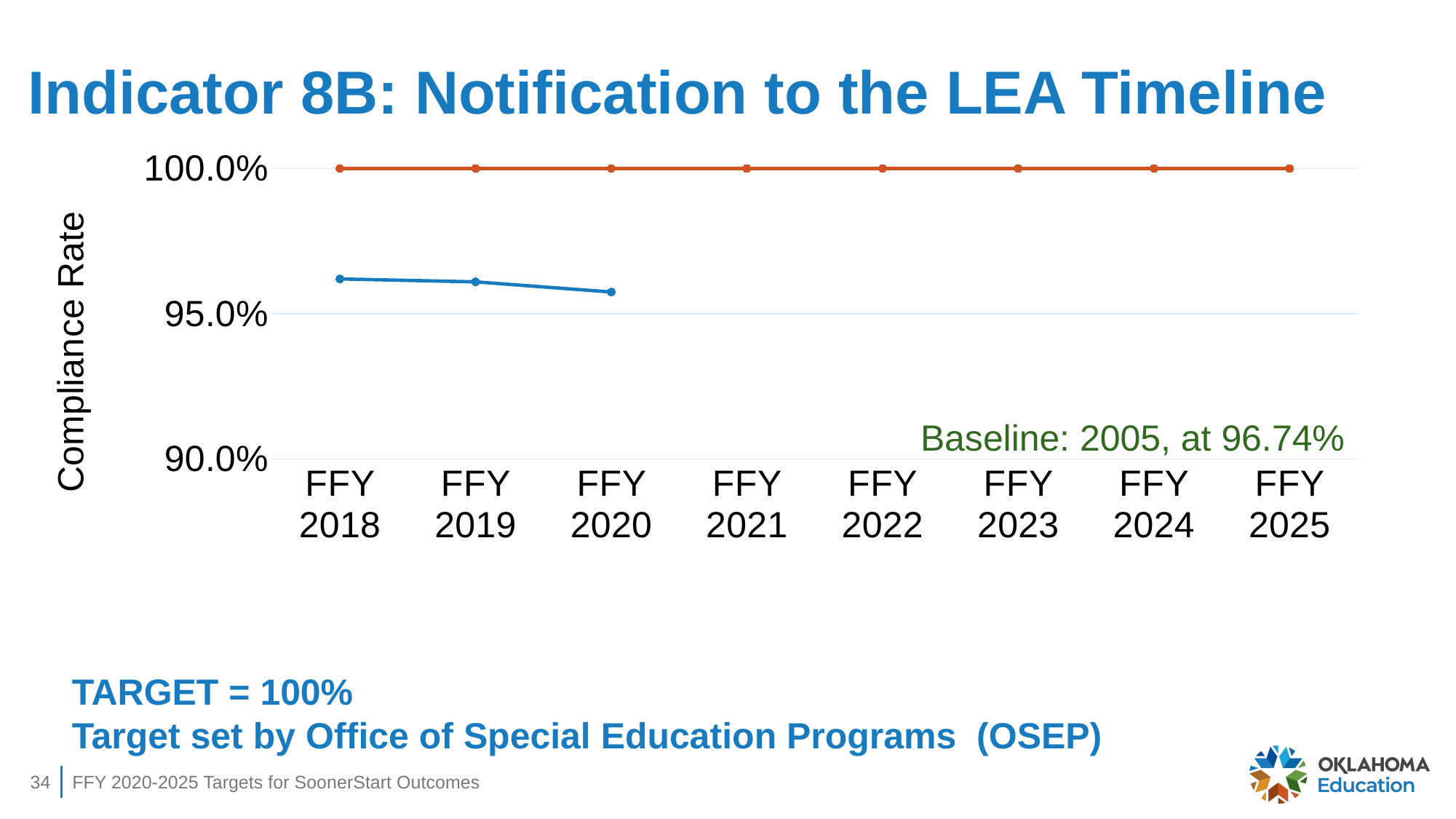
Does the blue line rise or fall from FFY 2018 to FFY 2020? fall What baseline is noted on the chart? Baseline: 2005, at 96.74% Which FFY has the lowest value on the blue line? FFY 2020 Is the value of the blue line for FFY 2018 greater or less than 100.0%? less What value does the orange target line show for FFY 2021? 100.0% How many FFY categories are shown on the x axis? 8 What is the last FFY category on the x axis? FFY 2025 What kind of chart is shown on the slide? line chart Which is larger on the blue line, the value for FFY 2018 or the value for FFY 2020? FFY 2018 What is the title of the y axis? Compliance Rate How many data points does the blue line have? 3 Is the value of the blue line for FFY 2020 greater or less than 95.0%? greater